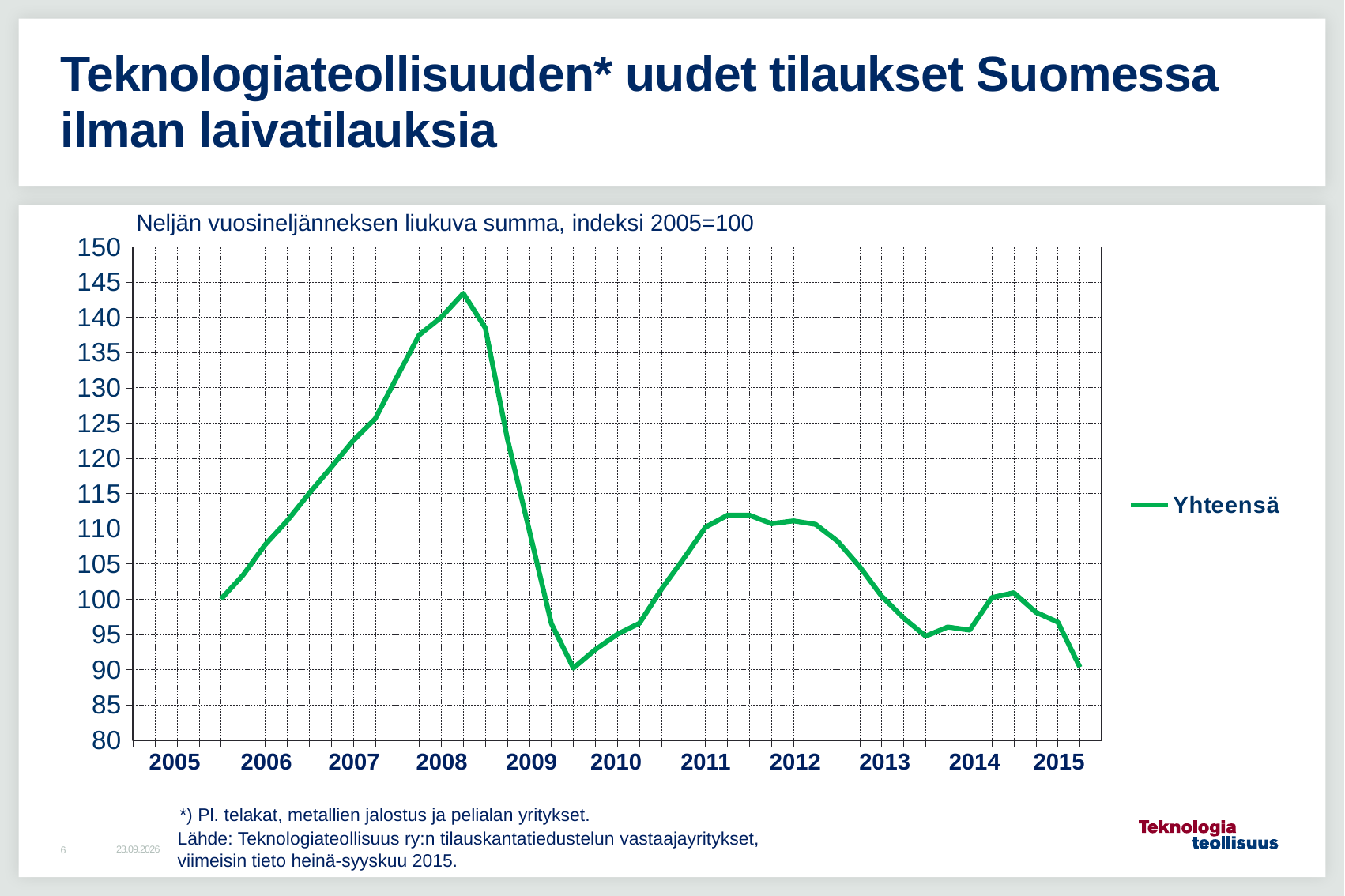
How many series does the legend list? 1 Does the line rise or fall between 2008 and 2009? fall What kind of chart is shown on the slide? line chart Does the line rise or fall between 2005 and 2008? rise What is the index value at the start of the line in 2005? 100 Is the peak value of the line in 2008 greater or less than 140? greater Is the lowest value of the line in 2009 greater or less than 95? less How many years are labelled on the x axis? 11 What is the name of the series shown in the legend? Yhteensä Is the value of the line at the end of 2015 greater or less than 95? less In which year does the line reach its highest value? 2008